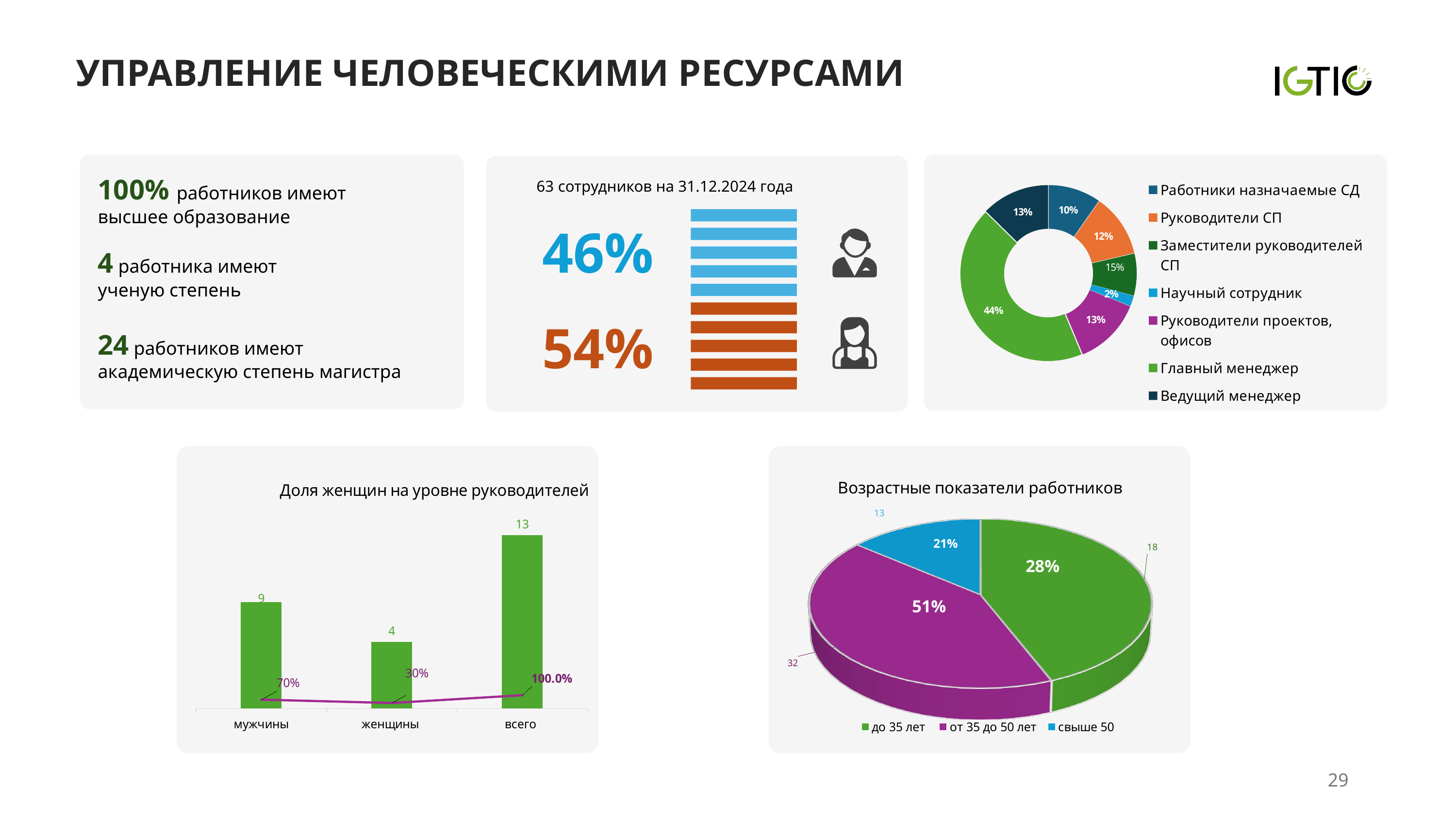
In the chart 'Доля женщин на уровне руководителей', what percentage is shown on the line for женщины? 30% In the donut chart at the top right, what share is shown for Главный менеджер? 44% In the chart 'Доля женщин на уровне руководителей', how many categories are on the x axis? 3 In the chart 'Возрастные показатели работников', which age group has the smallest share? свыше 50 In the donut chart at the top right, which category has the largest share? Главный менеджер In the donut chart at the top right, what share is shown for Заместители руководителей СП? 15% In the donut chart at the top right, how many categories does the legend list? 7 What kind of chart is 'Возрастные показатели работников'? pie chart In the donut chart at the top right, which category has the smallest share? Научный сотрудник In the chart 'Возрастные показатели работников', what share is shown for от 35 до 50 лет? 51% In the chart 'Доля женщин на уровне руководителей', what is the difference between the bars for мужчины and женщины? 5 In the chart 'Доля женщин на уровне руководителей', what is the value of the bar for мужчины? 9